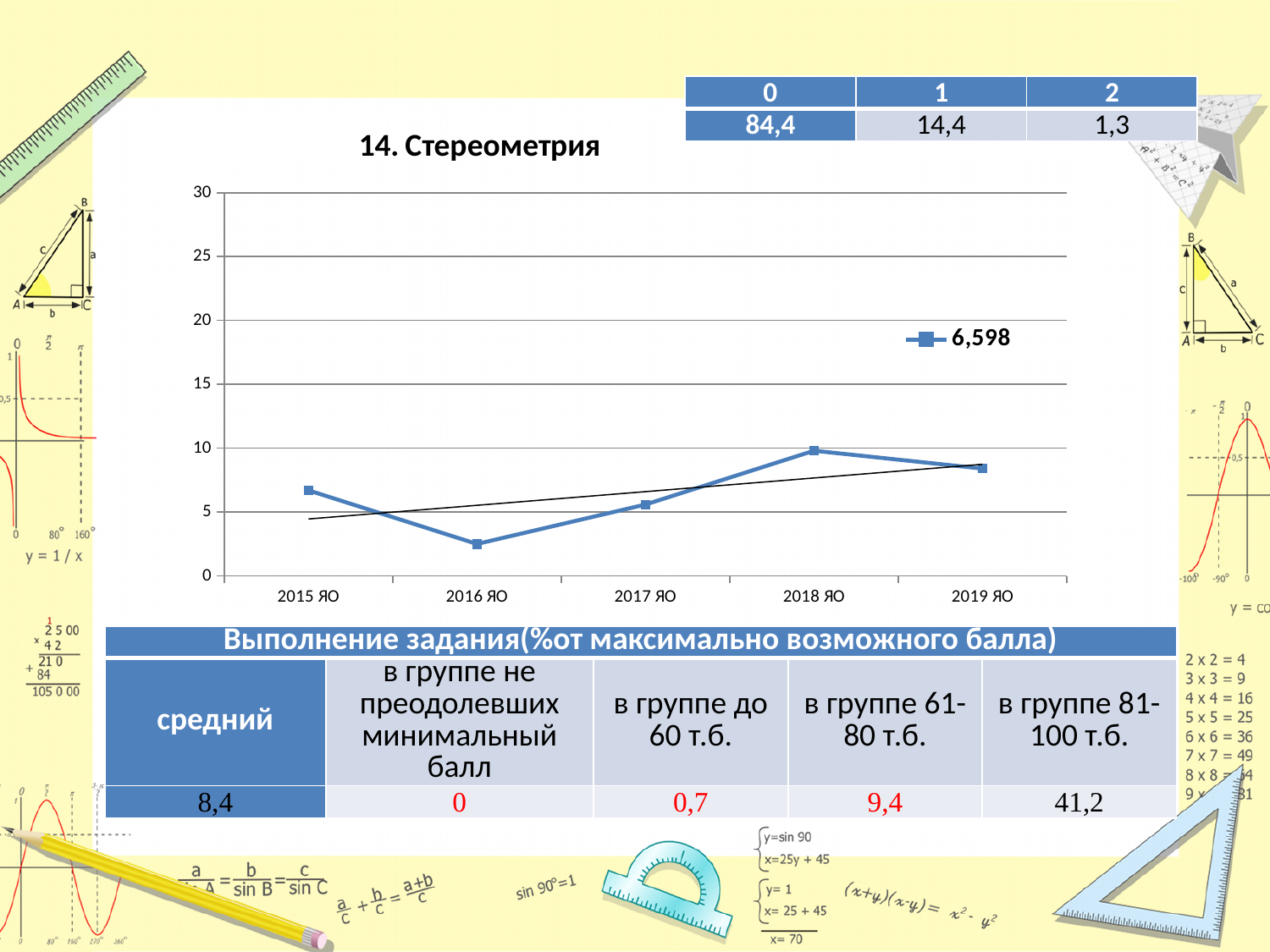
Is the value for 2015 ЯО greater or less than 5? greater Which is larger, the value for 2018 ЯО or the value for 2016 ЯО? 2018 ЯО Which is larger, the value for 2015 ЯО or the value for 2016 ЯО? 2015 ЯО Which year has the highest value on the chart? 2018 ЯО Do the values rise or fall from 2016 ЯО to 2018 ЯО? rise Which year has the lowest value on the chart? 2016 ЯО How many data points (years) are plotted on the x axis of the chart? 5 What kind of chart is shown under the title "14. Стереометрия"? line chart What label does the chart legend show for the plotted series? 6,598 Is the value for 2016 ЯО greater or less than 5? less How many series does the chart legend list? 1